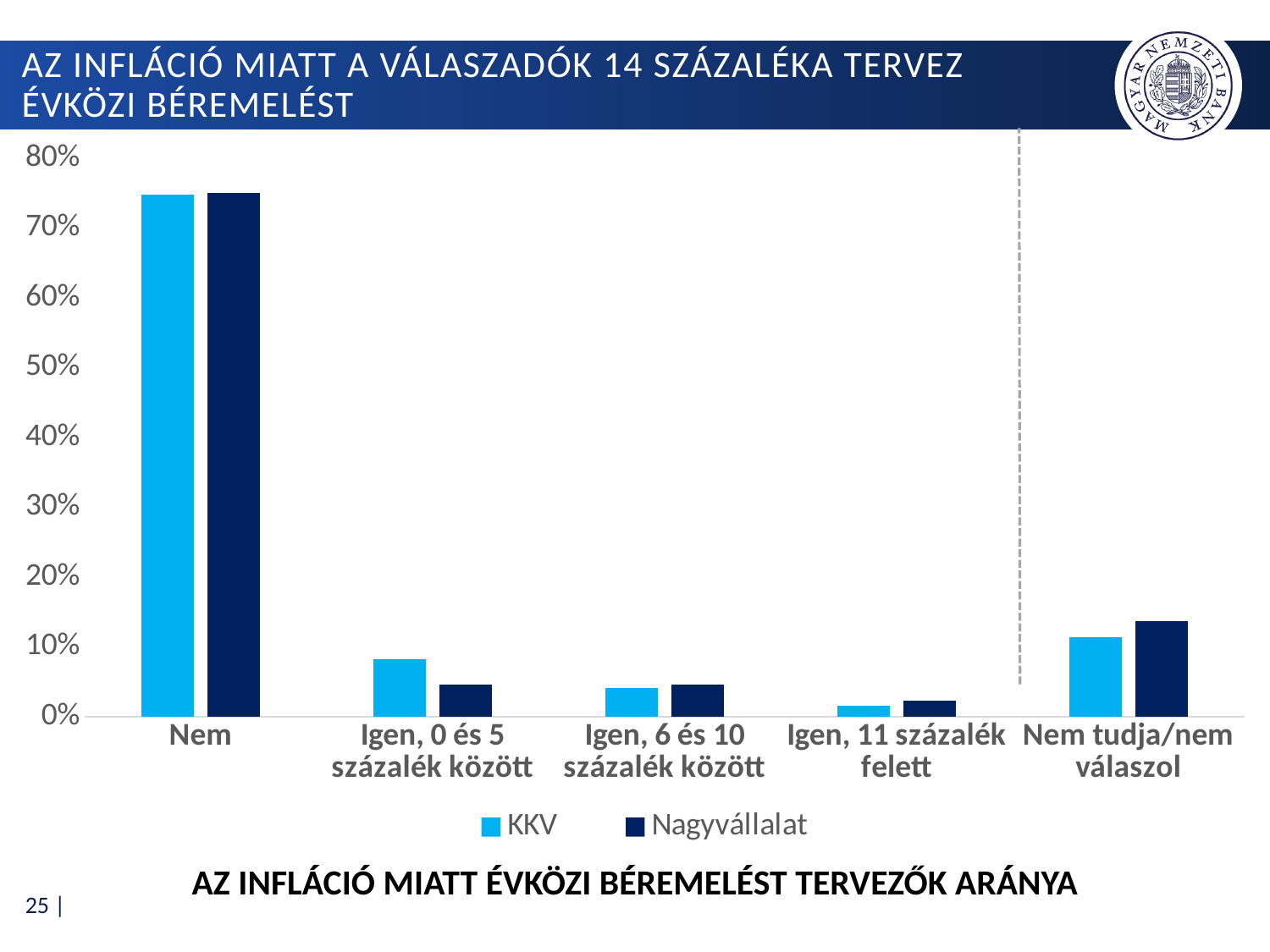
Is the Nagyvállalat value for 'Igen, 11 százalék felett' greater or less than 10%? less For 'Igen, 0 és 5 százalék között', which series has the larger value, KKV or Nagyvállalat? KKV How many categories are shown along the x axis of the chart? 5 How many series does the chart's legend list? 2 What kind of chart is shown on the slide? bar chart Which category has the highest values for both series? Nem Which category has the lowest value for the KKV series? Igen, 11 százalék felett What is the title shown below the chart's legend? AZ INFLÁCIÓ MIATT ÉVKÖZI BÉREMELÉST TERVEZŐK ARÁNYA Is the KKV value for 'Nem' greater or less than 70%? greater Is the Nagyvállalat value for 'Nem tudja/nem válaszol' greater or less than 10%? greater For 'Nem tudja/nem válaszol', which series has the larger value, KKV or Nagyvállalat? Nagyvállalat